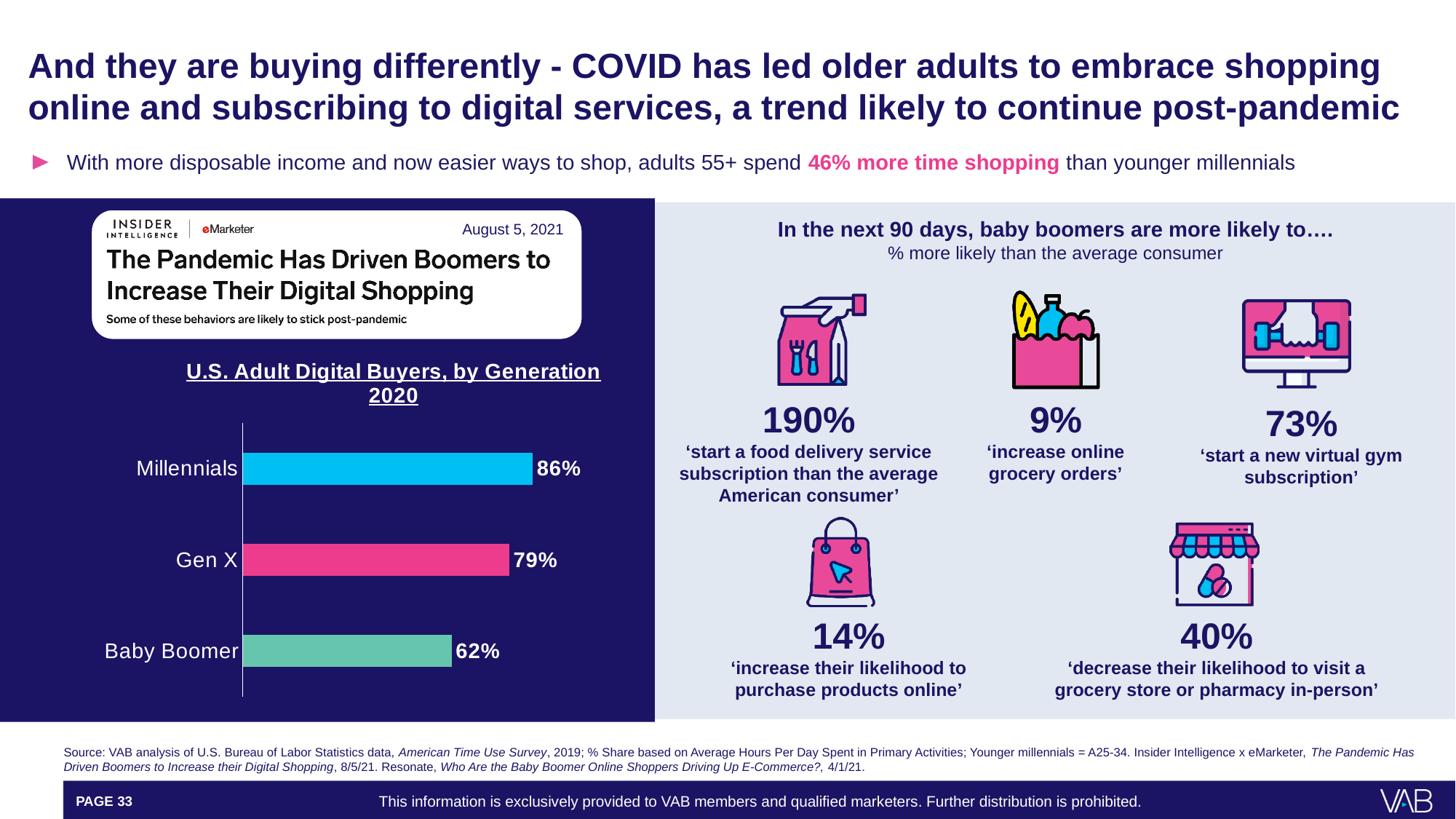
What kind of chart is the 'U.S. Adult Digital Buyers, by Generation 2020' chart? Bar chart In the 'U.S. Adult Digital Buyers, by Generation 2020' chart, what is the difference between the Gen X and Baby Boomer values? 17% What is the value for Millennials in the 'U.S. Adult Digital Buyers, by Generation 2020' chart? 86% How many generations are shown in the 'U.S. Adult Digital Buyers, by Generation 2020' chart? 3 What is the value for Baby Boomer in the 'U.S. Adult Digital Buyers, by Generation 2020' chart? 62% In the 'U.S. Adult Digital Buyers, by Generation 2020' chart, which is larger: the value for Gen X or the value for Baby Boomer? Gen X What is the title of the bar chart on the left side of the slide? U.S. Adult Digital Buyers, by Generation 2020 What colour is the Baby Boomer bar in the 'U.S. Adult Digital Buyers, by Generation 2020' chart? Green In the 'U.S. Adult Digital Buyers, by Generation 2020' chart, what is the difference between the Millennials and Baby Boomer values? 24% What is the value for Gen X in the 'U.S. Adult Digital Buyers, by Generation 2020' chart? 79% Which generation has the highest share of digital buyers in the 'U.S. Adult Digital Buyers, by Generation 2020' chart? Millennials Which generation has the lowest share of digital buyers in the 'U.S. Adult Digital Buyers, by Generation 2020' chart? Baby Boomer